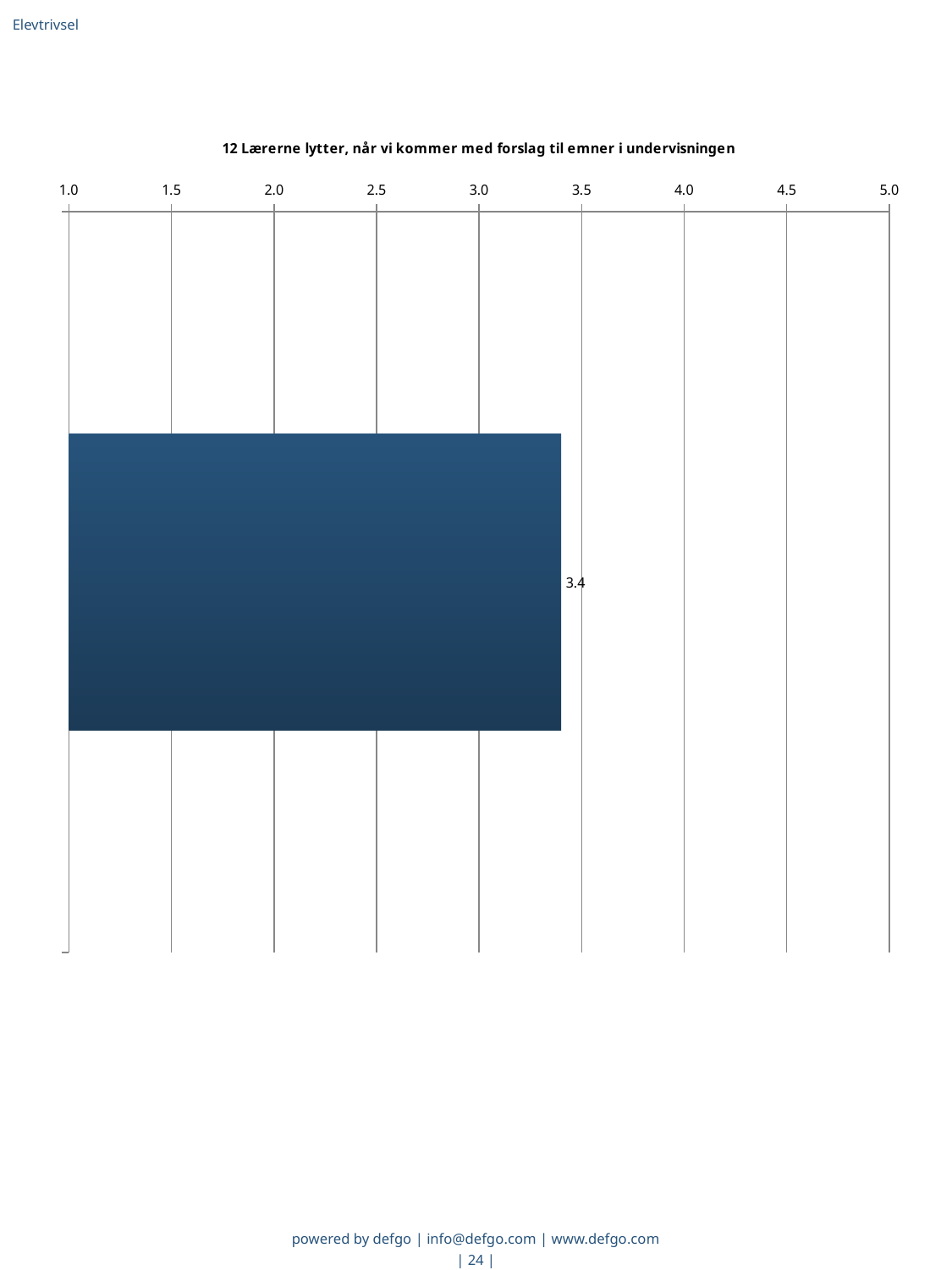
Is the value of the bar greater or less than 3.5? less What is the highest value shown on the chart's horizontal axis? 5.0 Is the value of the bar greater or less than 3.0? greater What kind of chart is shown on the slide? bar chart How many bars are plotted in the chart? 1 What is the title of the chart? 12 Lærerne lytter, når vi kommer med forslag til emner i undervisningen What value is shown by the bar in the chart? 3.4 Is the value of the bar greater or less than 4.0? less